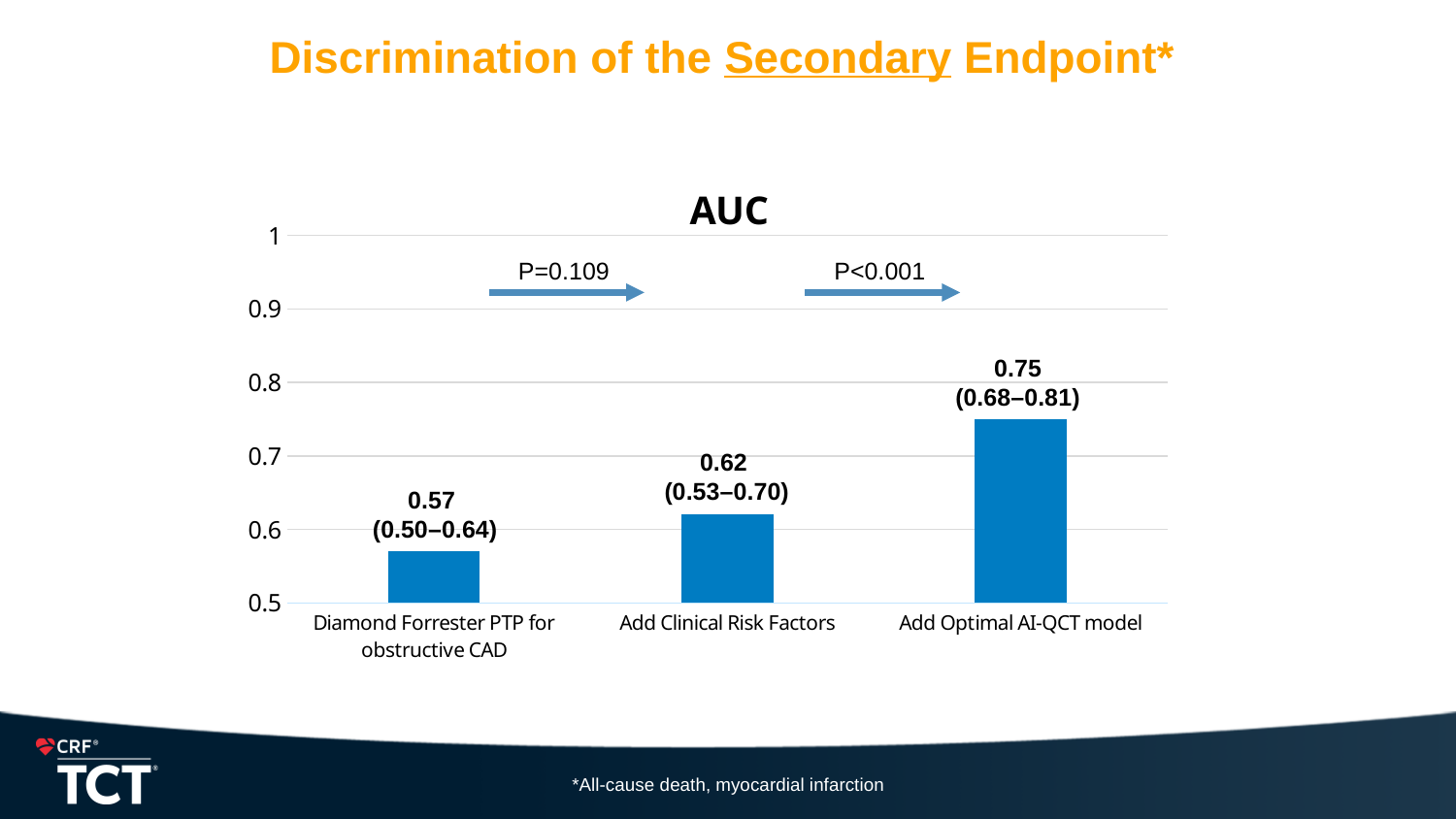
Do the AUC values rise or fall from left to right across the categories? Rise What is the difference in AUC between Add Optimal AI-QCT model and Add Clinical Risk Factors? 0.13 Which category has the lowest AUC? Diamond Forrester PTP for obstructive CAD What kind of chart is shown on the slide? Bar chart What is the AUC value for Add Optimal AI-QCT model? 0.75 Which category has the highest AUC? Add Optimal AI-QCT model What is the AUC value for Diamond Forrester PTP for obstructive CAD? 0.57 Which has a larger AUC, Add Clinical Risk Factors or Add Optimal AI-QCT model? Add Optimal AI-QCT model What is the AUC value for Add Clinical Risk Factors? 0.62 Is the AUC for Add Optimal AI-QCT model greater or less than 0.7? greater What is the difference in AUC between Add Clinical Risk Factors and Diamond Forrester PTP for obstructive CAD? 0.05 How many categories are shown on the chart? 3